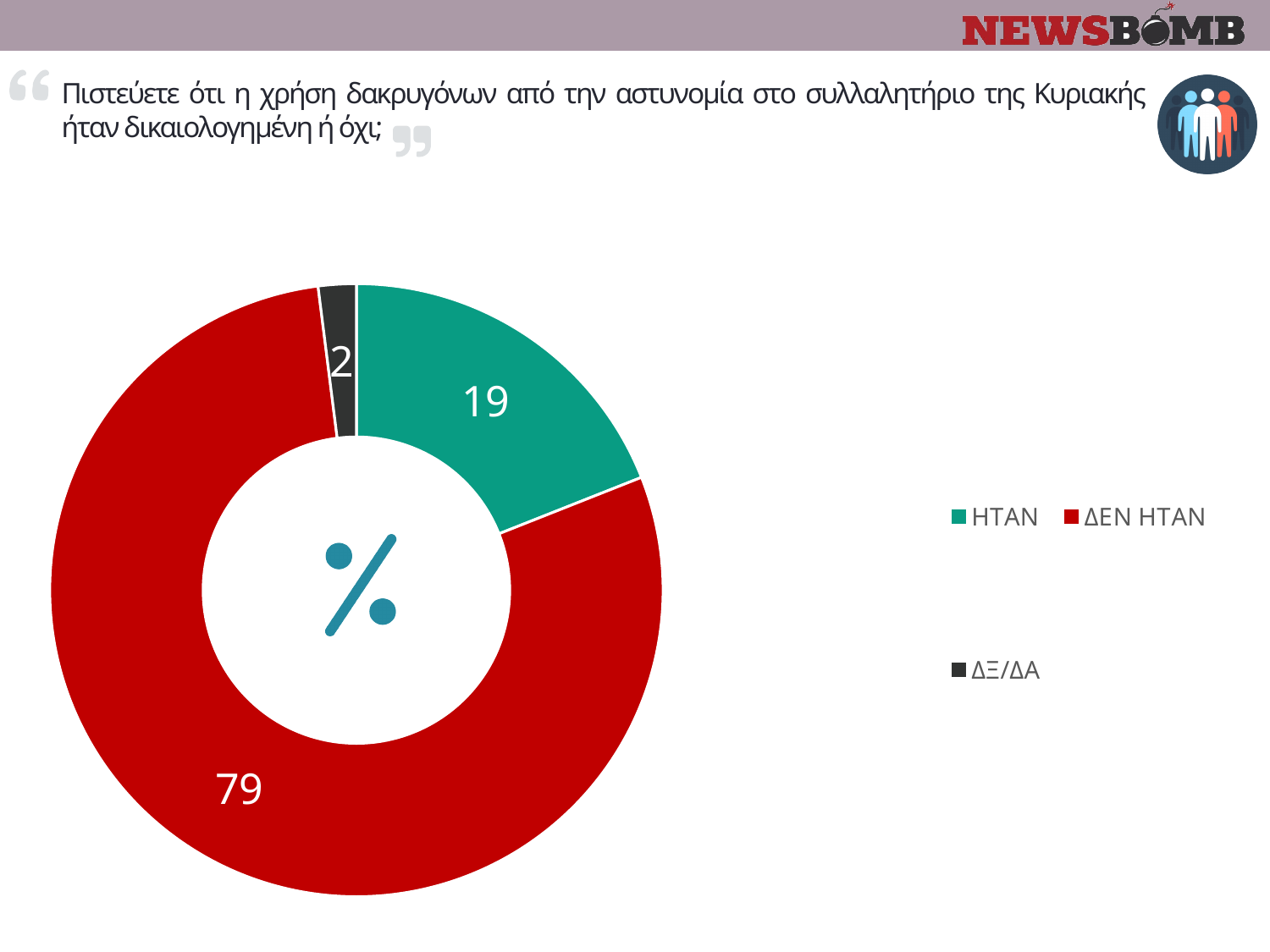
What is the difference between the values for ΔΕΝ ΗΤΑΝ and ΗΤΑΝ? 60 What is the value for ΔΕΝ ΗΤΑΝ? 79 How many categories are shown in the chart? 3 What is the value for ΗΤΑΝ? 19 Which category has the smallest share of the chart? ΔΞ/ΔΑ What symbol is shown in the centre of the doughnut chart? % What kind of chart is shown on the slide? Doughnut (pie) chart What colour is the ΔΕΝ ΗΤΑΝ slice? Red Which category has the largest share of the chart? ΔΕΝ ΗΤΑΝ How many entries does the legend list? 3 Which is larger, ΗΤΑΝ or ΔΞ/ΔΑ? ΗΤΑΝ What is the value for ΔΞ/ΔΑ? 2